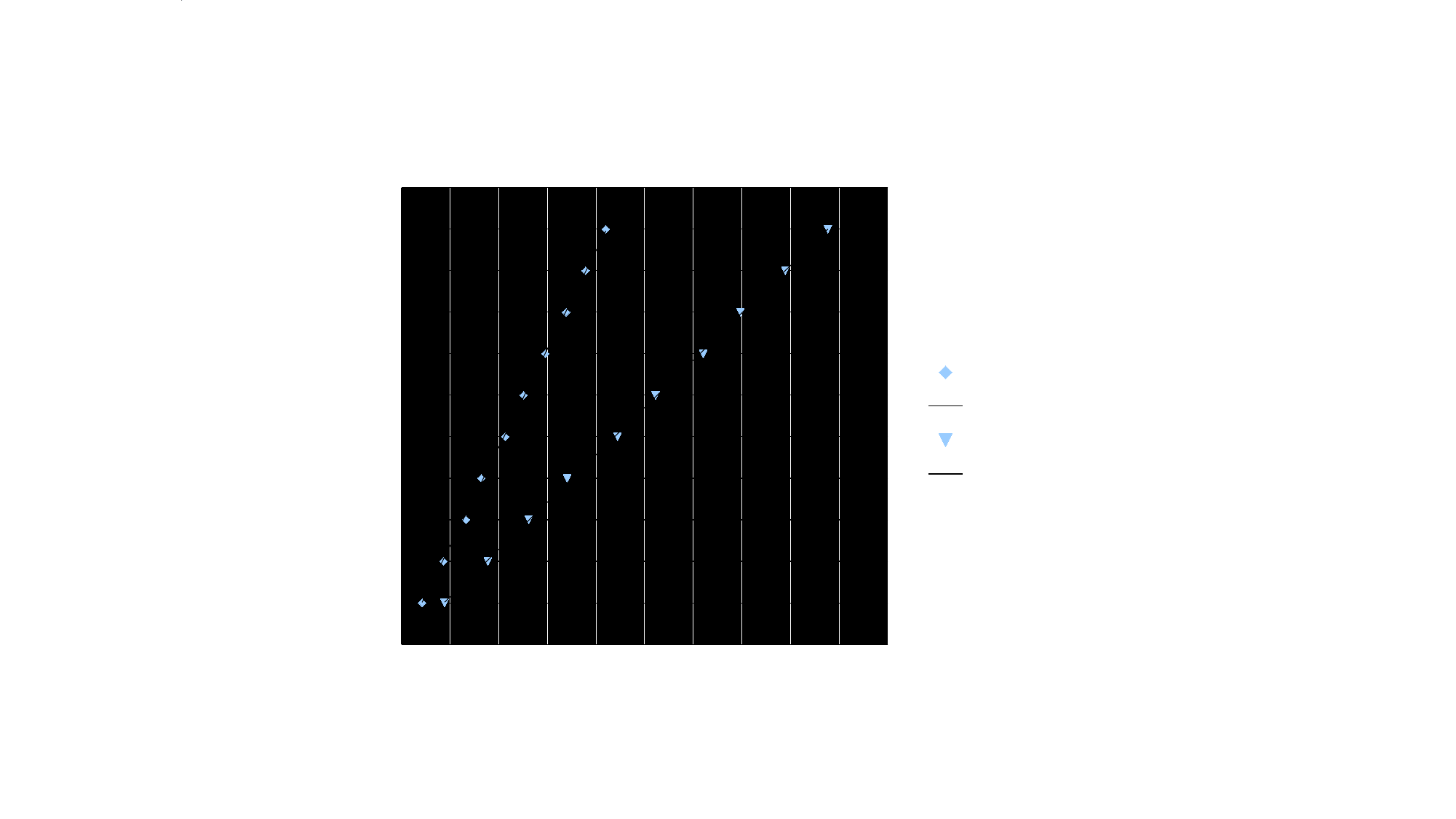
Do the values of the diamond-marker series rise or fall as you move right along the x axis? rise What marker shape is used for the first series in the legend? diamond What colour are the plotted markers? light blue What kind of chart is shown on the slide? scatter chart How many points are plotted in the diamond-marker series? 10 How many points are plotted in the triangle-marker series? 10 Do the values of the triangle-marker series rise or fall as you move right along the x axis? rise How many series does the legend list? 2